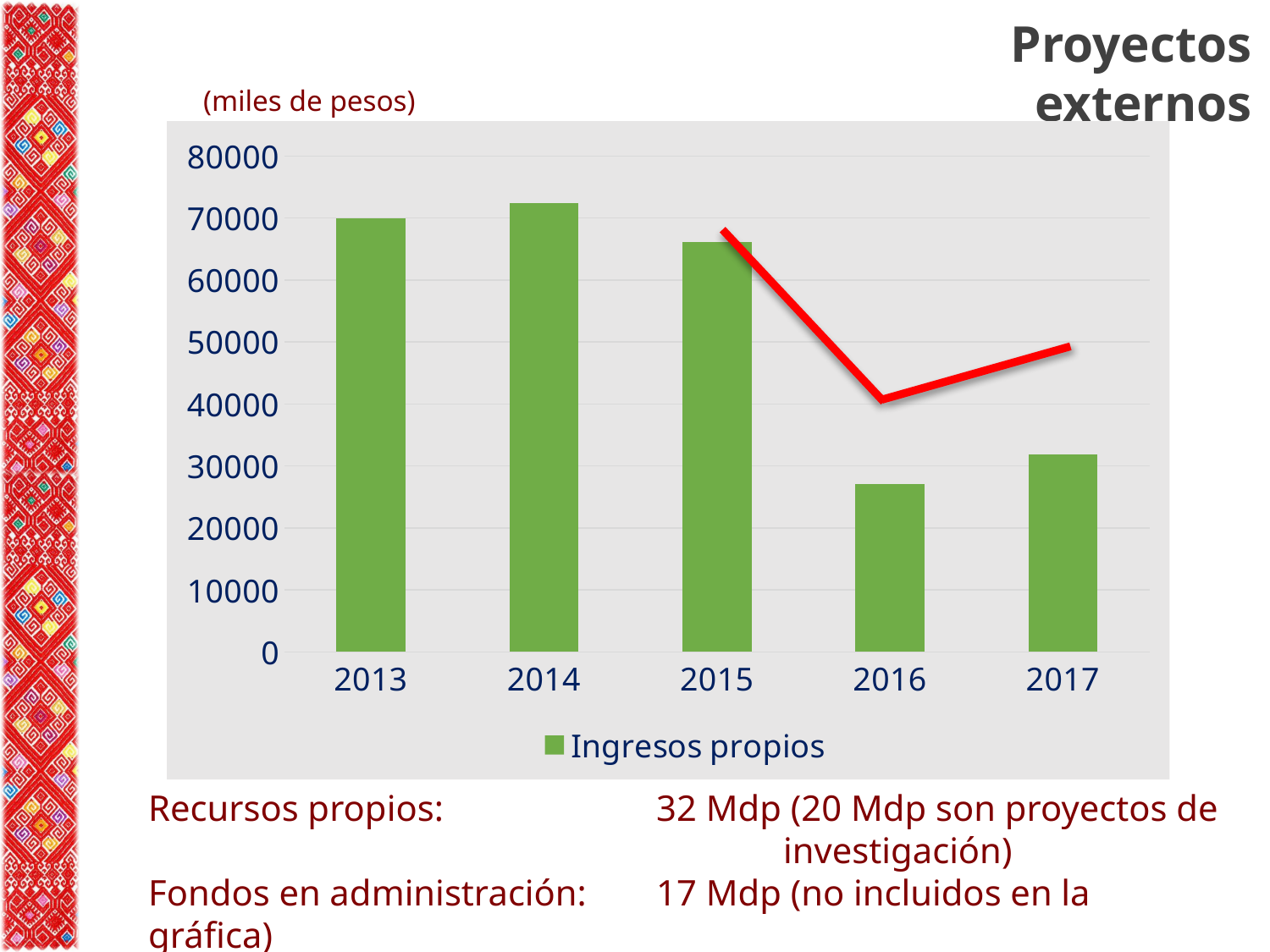
How many years are shown on the x axis of the chart? 5 How many series does the chart's legend list? 1 What kind of chart is shown on the slide? bar chart Is the value for 2017 greater or less than 30000? greater What series name is shown in the chart's legend? Ingresos propios Is the value for 2016 greater or less than 30000? less Which is larger, the value for 2015 or the value for 2016? 2015 Which year has the lowest value for Ingresos propios? 2016 Which year has the highest value for Ingresos propios? 2014 Is the value for 2015 greater or less than 70000? less Do the values for Ingresos propios rise or fall from 2013 to 2016? fall